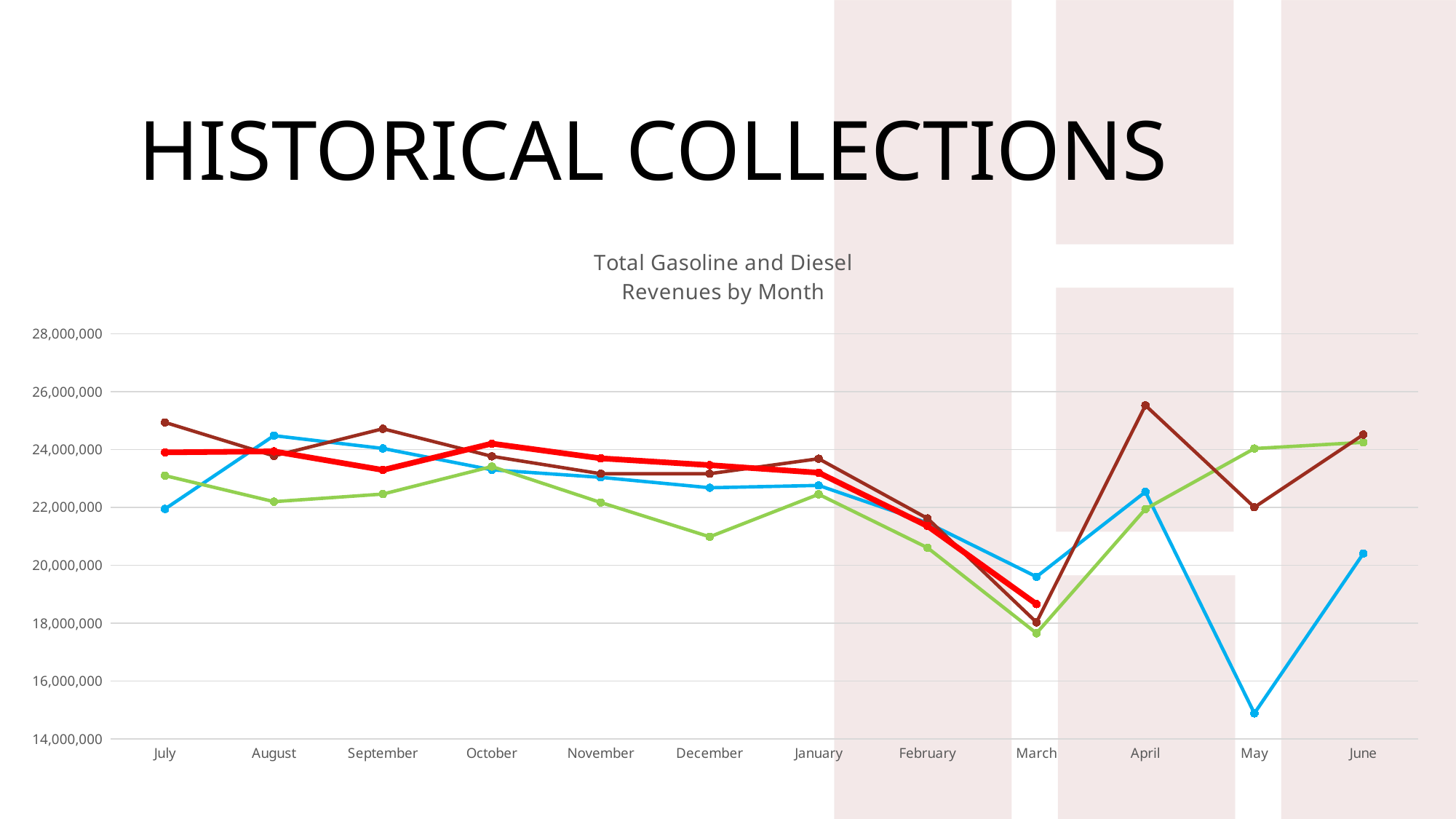
Is the value of the thick red line in March greater or less than 20,000,000? less Does the light blue line rise or fall from April to May? Fall How many months are shown on the x axis of the chart? 12 Is the value of the dark red line in April greater or less than 24,000,000? greater What kind of chart is shown on the slide? Line chart In which month does the dark red line reach its highest value? April What is the title of the chart? Total Gasoline and Diesel Revenues by Month In which month does the light blue line reach its lowest value? May How many lines are plotted on the chart? 4 In May, which line has the larger value, the green line or the light blue line? Green line Is the value of the light blue line in May greater or less than 16,000,000? less In which month does the green line reach its lowest value? March